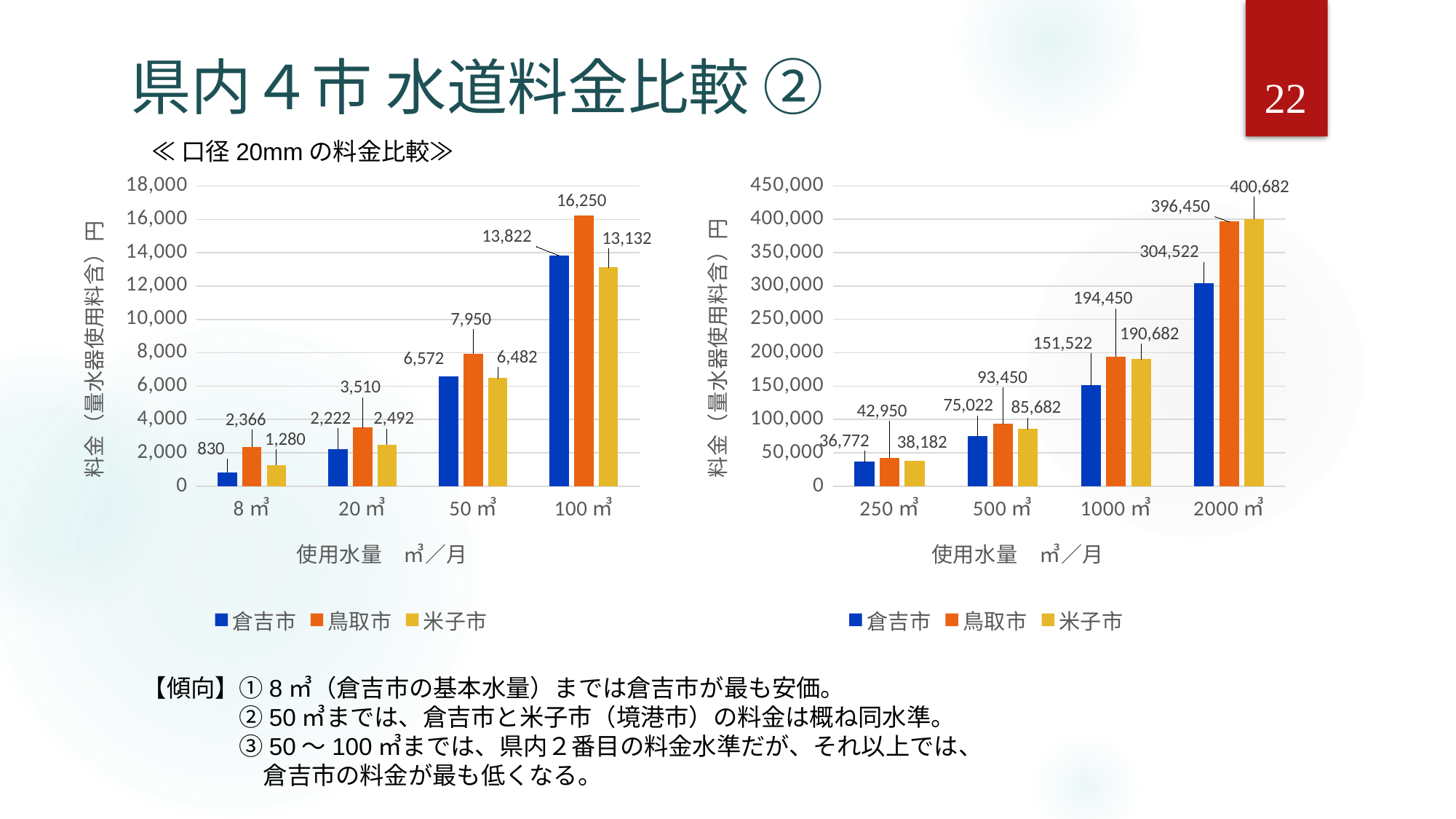
In the left chart (8 m³ to 100 m³), what is the value for 倉吉市 at 8 m³? 830 In the right chart (250 m³ to 2000 m³), which is larger at 1000 m³: 鳥取市 or 米子市? 鳥取市 In the right chart (250 m³ to 2000 m³), what is the value for 米子市 at 2000 m³? 400,682 In the left chart (8 m³ to 100 m³), what is the value for 鳥取市 at 100 m³? 16,250 How many series does the legend of the left chart list? 3 How many usage categories are shown on the x axis of the right chart? 4 In the right chart (250 m³ to 2000 m³), what is the value for 倉吉市 at 1000 m³? 151,522 In the left chart (8 m³ to 100 m³), what is the difference between 鳥取市 and 倉吉市 at 20 m³? 1,288 In the right chart (250 m³ to 2000 m³), what is the difference between 鳥取市 and 米子市 at 500 m³? 7,768 In the left chart (8 m³ to 100 m³), which city has the highest value at 50 m³? 鳥取市 In the right chart (250 m³ to 2000 m³), which city has the lowest value at 2000 m³? 倉吉市 What kind of chart is the left chart? Bar chart